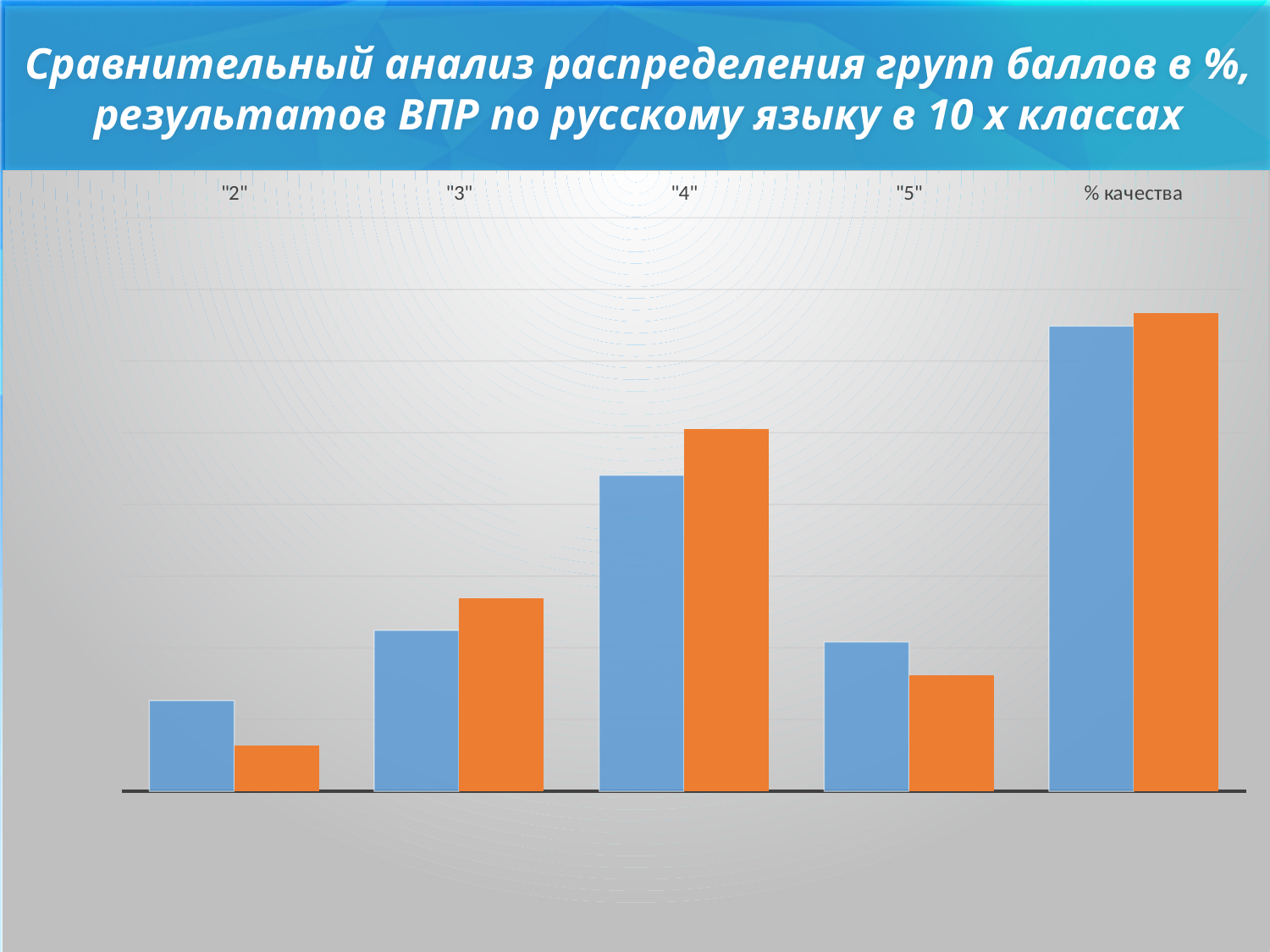
How many categories are shown along the x axis of the chart? 5 For the category "2", which bar is taller, the blue one or the orange one? blue Which category has the shortest blue bar? "2" For the category "4", which bar is taller, the blue one or the orange one? orange What kind of chart is shown on the slide? bar chart Among the score categories "2", "3", "4" and "5", which has the tallest orange bar? "4" For the category "3", which bar is taller, the blue one or the orange one? orange Which category has the tallest blue bar? % качества Which category has the shortest orange bar? "2" What is the label of the last category on the x axis of the chart? % качества Which category has the tallest orange bar? % качества